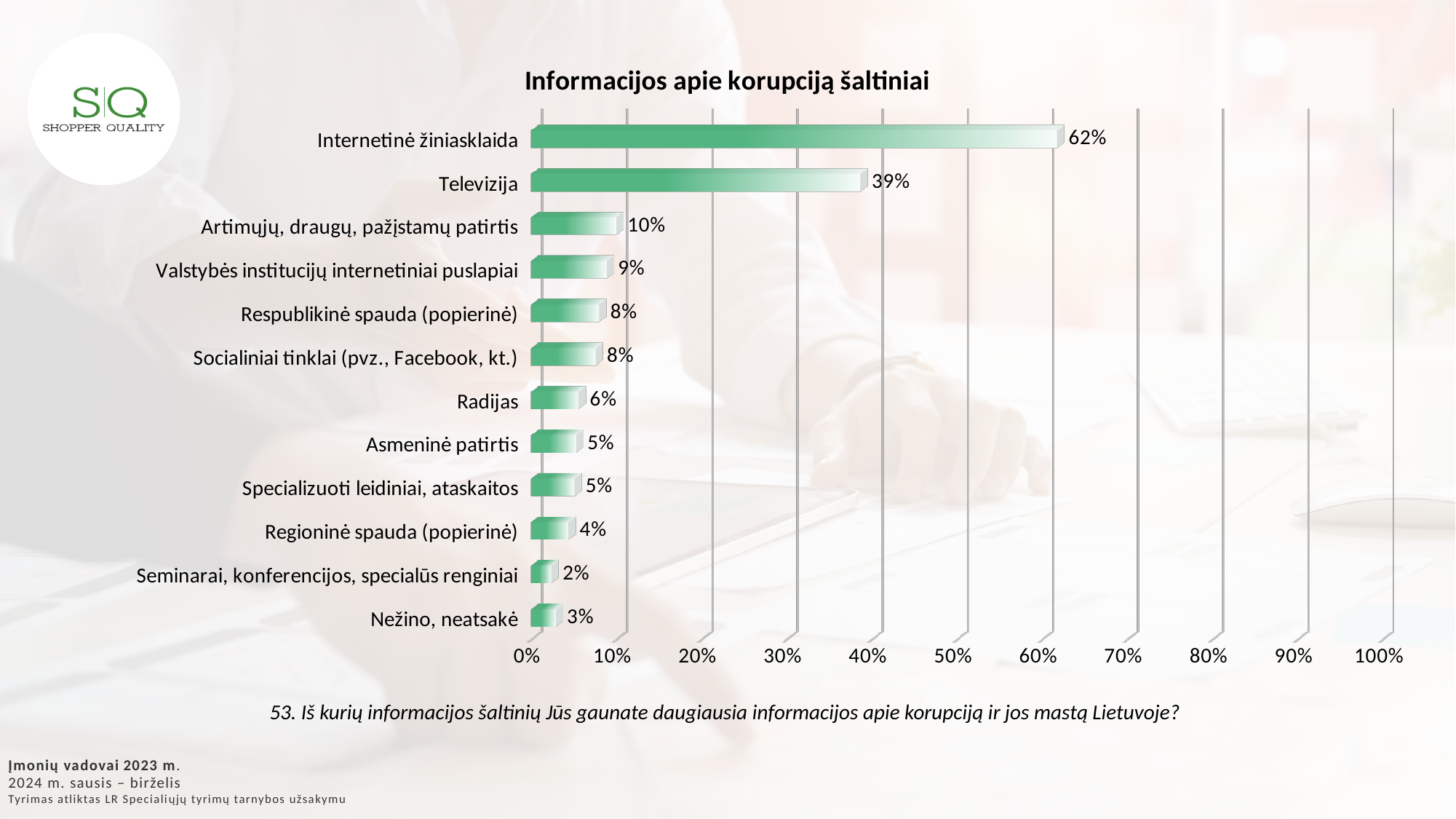
What is the value for Televizija? 39% What kind of chart is shown on the slide? bar chart How many categories are shown in the chart? 12 What is the difference between the values for Internetinė žiniasklaida and Televizija? 23% What is the value for Internetinė žiniasklaida? 62% Which category has the highest value? Internetinė žiniasklaida Is the value for Televizija greater or less than 50%? less What is the value for Radijas? 6% Which category has the lowest value? Seminarai, konferencijos, specialūs renginiai What is the title of the chart? Informacijos apie korupciją šaltiniai What is the value for Seminarai, konferencijos, specialūs renginiai? 2% Which is larger, the value for Artimųjų, draugų, pažįstamų patirtis or the value for Regioninė spauda (popierinė)? Artimųjų, draugų, pažįstamų patirtis